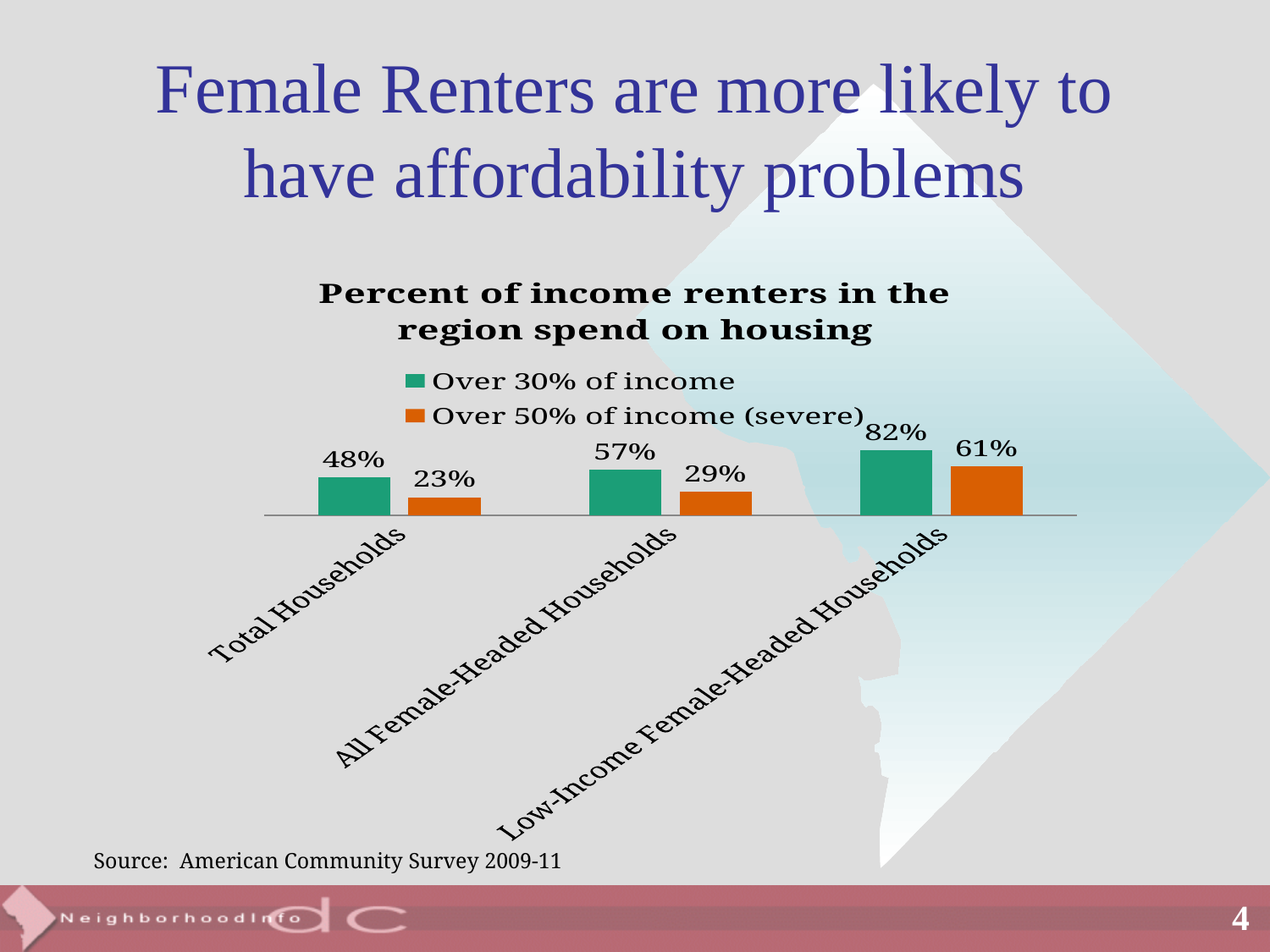
How many household categories are shown on the x axis? 3 Which category has the lowest value for Over 50% of income (severe)? Total Households Which category has the highest value for Over 30% of income? Low-Income Female-Headed Households What percentage of Total Households spend over 30% of income on housing? 48% How many series does the legend list? 2 What percentage of Low-Income Female-Headed Households spend over 50% of income (severe) on housing? 61% What kind of chart is shown on the slide? Bar chart What is the title of the chart? Percent of income renters in the region spend on housing What is the difference between the Over 30% of income and Over 50% of income (severe) values for Total Households? 25% Which is larger: the Over 50% of income (severe) value for All Female-Headed Households or for Total Households? All Female-Headed Households How much higher is the Over 30% of income value for Low-Income Female-Headed Households than for All Female-Headed Households? 25% What is the value for All Female-Headed Households in the Over 30% of income series? 57%